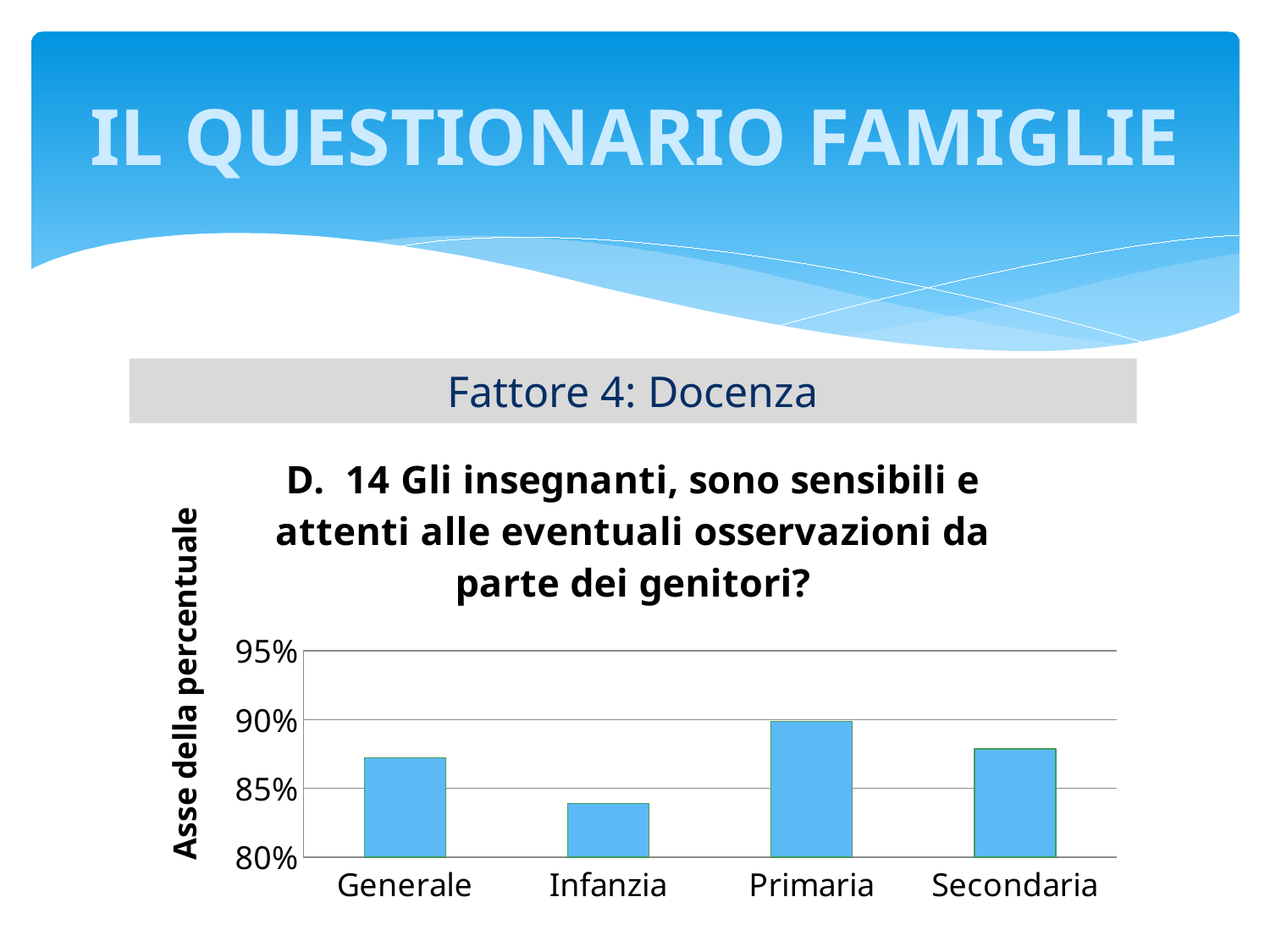
Which category has the highest value in the chart? Primaria Which category has the lowest value in the chart? Infanzia How many categories are shown on the x axis of the chart? 4 What kind of chart is shown on the slide? bar chart Is the value for Secondaria greater or less than 90%? less Is the value for Infanzia greater or less than 85%? less Is the value for Primaria greater or less than 85%? greater What is the label of the vertical axis of the chart? Asse della percentuale What is the title of the chart? D. 14 Gli insegnanti, sono sensibili e attenti alle eventuali osservazioni da parte dei genitori? Which is larger, the value for Primaria or the value for Infanzia? Primaria Which is larger, the value for Secondaria or the value for Infanzia? Secondaria